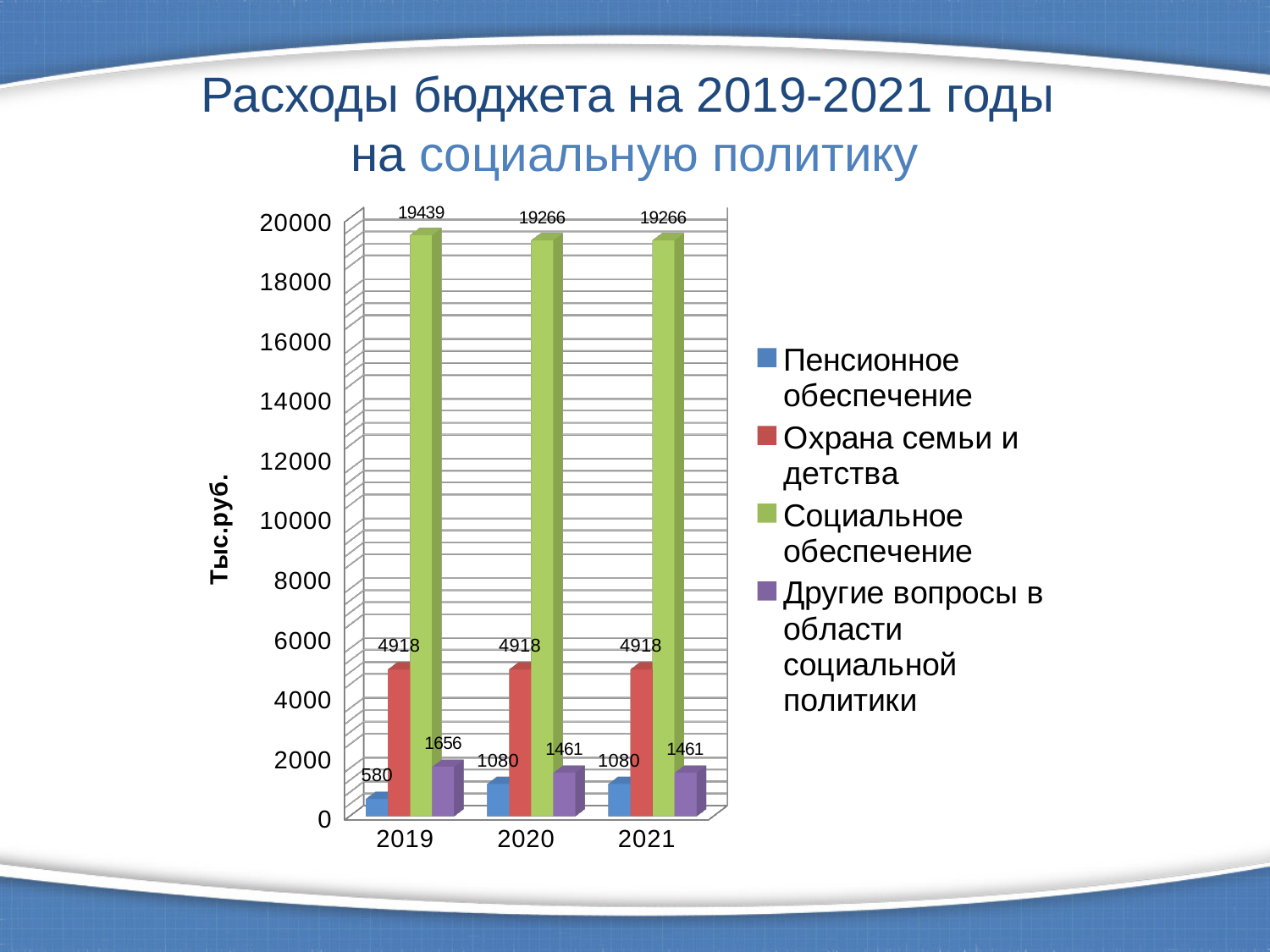
What is the label of the vertical axis? Тыс.руб. Which is larger: Пенсионное обеспечение in 2019 or Пенсионное обеспечение in 2020? Пенсионное обеспечение in 2020 Which series has the highest value in 2019? Социальное обеспечение What kind of chart is shown on the slide? Bar chart What is the difference between the Социальное обеспечение values for 2019 and 2020? 173 How many series does the legend list? 4 How many years are shown on the x axis? 3 Which series has the lowest value in 2020? Пенсионное обеспечение What is the value for Пенсионное обеспечение in 2019? 580 What is the value for Другие вопросы в области социальной политики in 2019? 1656 What is the value for Охрана семьи и детства in 2021? 4918 What is the value for Социальное обеспечение in 2020? 19266